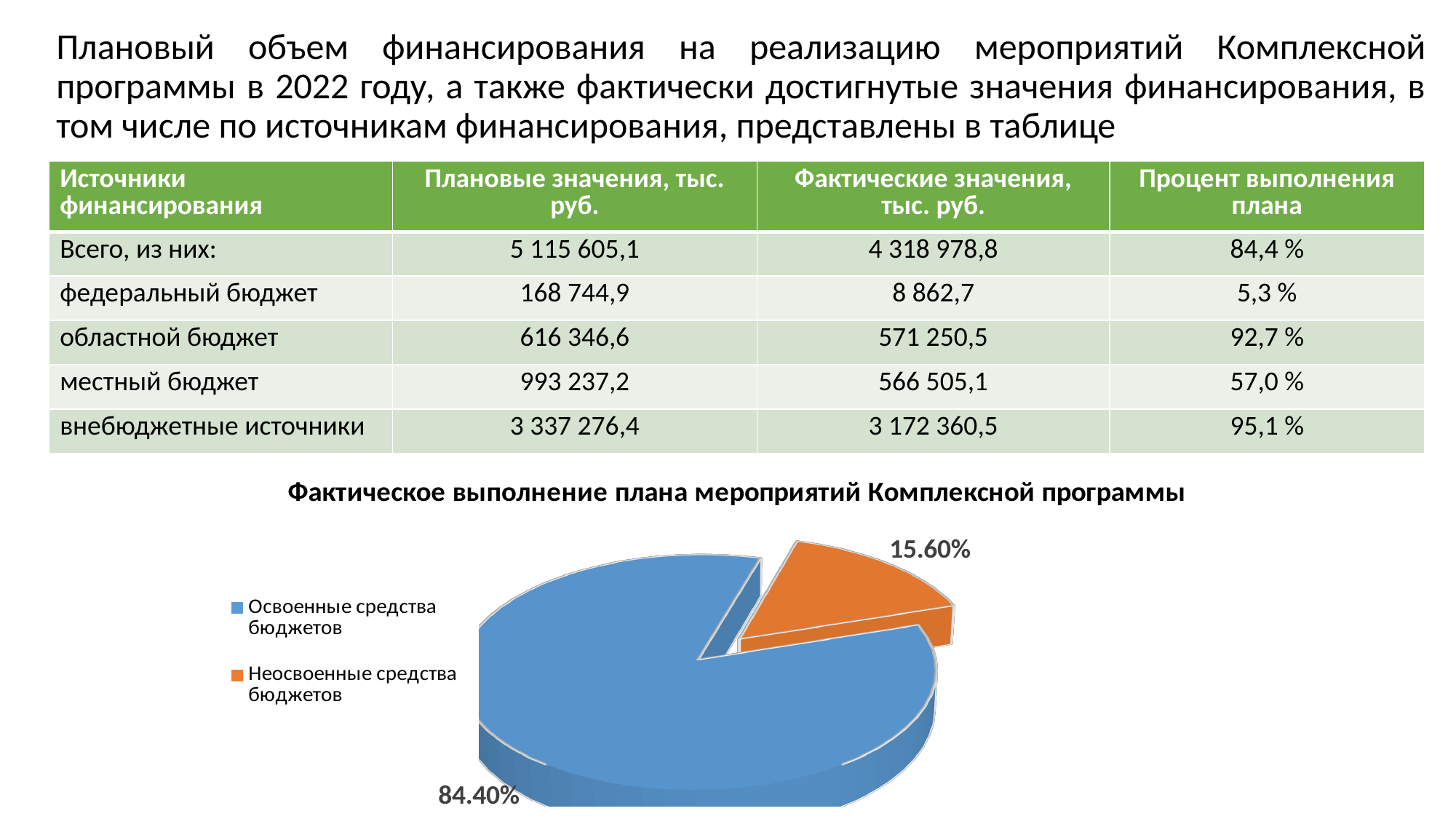
How many slices does the pie chart have? 2 What is the difference in percentage points between the "Освоенные средства бюджетов" slice and the "Неосвоенные средства бюджетов" slice? 68.80% What share of the pie does "Неосвоенные средства бюджетов" represent? 15.60% How many entries does the legend of the pie chart list? 2 Which is larger in the pie chart: "Освоенные средства бюджетов" or "Неосвоенные средства бюджетов"? Освоенные средства бюджетов What colour is the "Неосвоенные средства бюджетов" slice in the pie chart? orange Which slice of the pie chart is the largest? Освоенные средства бюджетов What kind of chart is shown on the slide? pie chart What is the title of the pie chart? Фактическое выполнение плана мероприятий Комплексной программы Which slice of the pie chart is the smallest? Неосвоенные средства бюджетов What share of the pie does "Освоенные средства бюджетов" represent? 84.40%